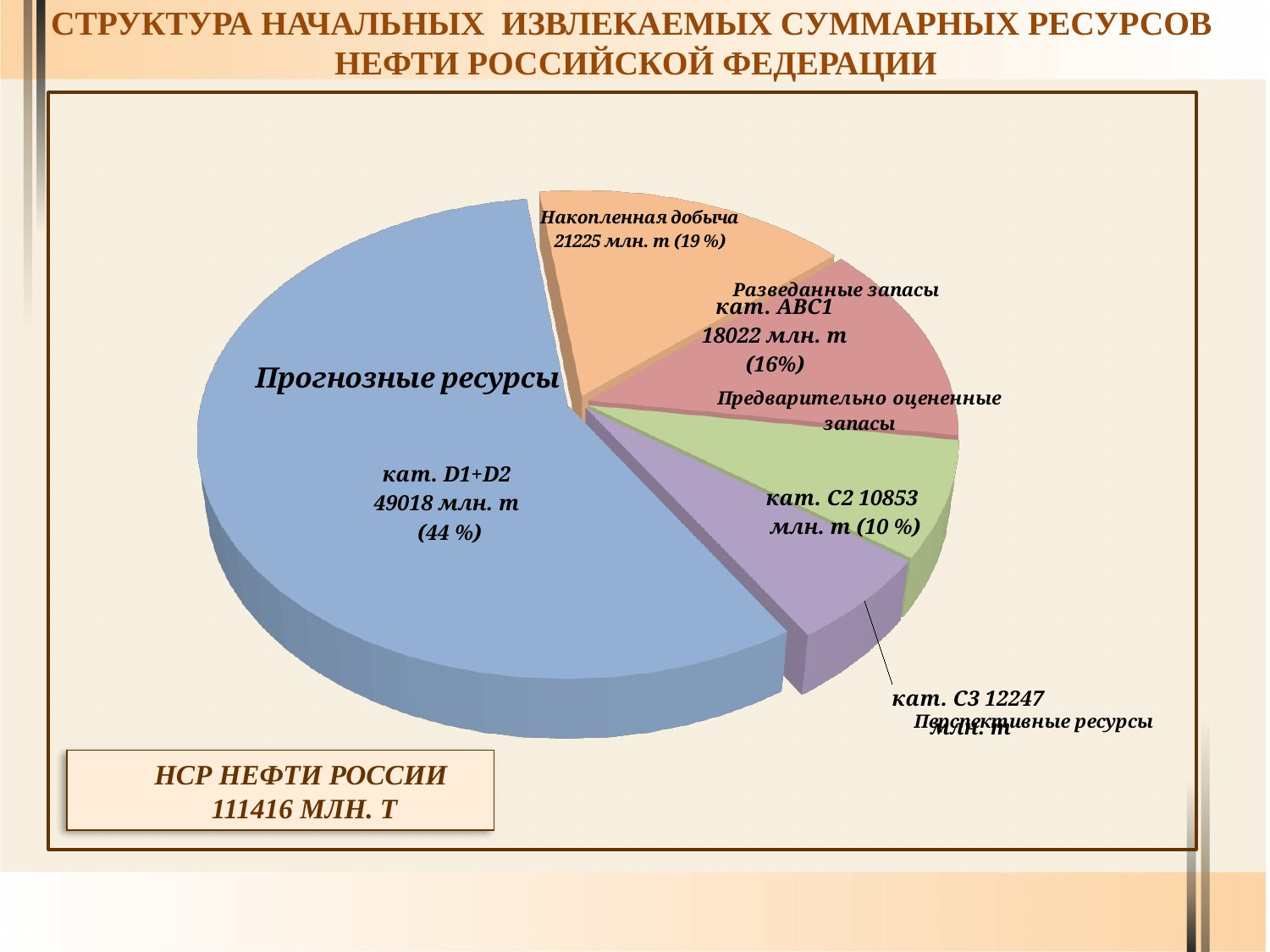
What is the difference between the values for кат. ABC1 and кат. C2? 7169 млн. т What is the value for кат. D1+D2? 49018 млн. т What kind of chart is shown on the slide? pie chart Which category has the largest slice of the pie? кат. D1+D2 What is the value for кат. C2? 10853 млн. т What is the value for кат. C3? 12247 млн. т What is the value for Накопленная добыча? 21225 млн. т How many slices does the pie chart have? 5 What share of the pie does кат. D1+D2 represent? 44 % What is the value for кат. ABC1? 18022 млн. т What share of the pie does Накопленная добыча represent? 19 %